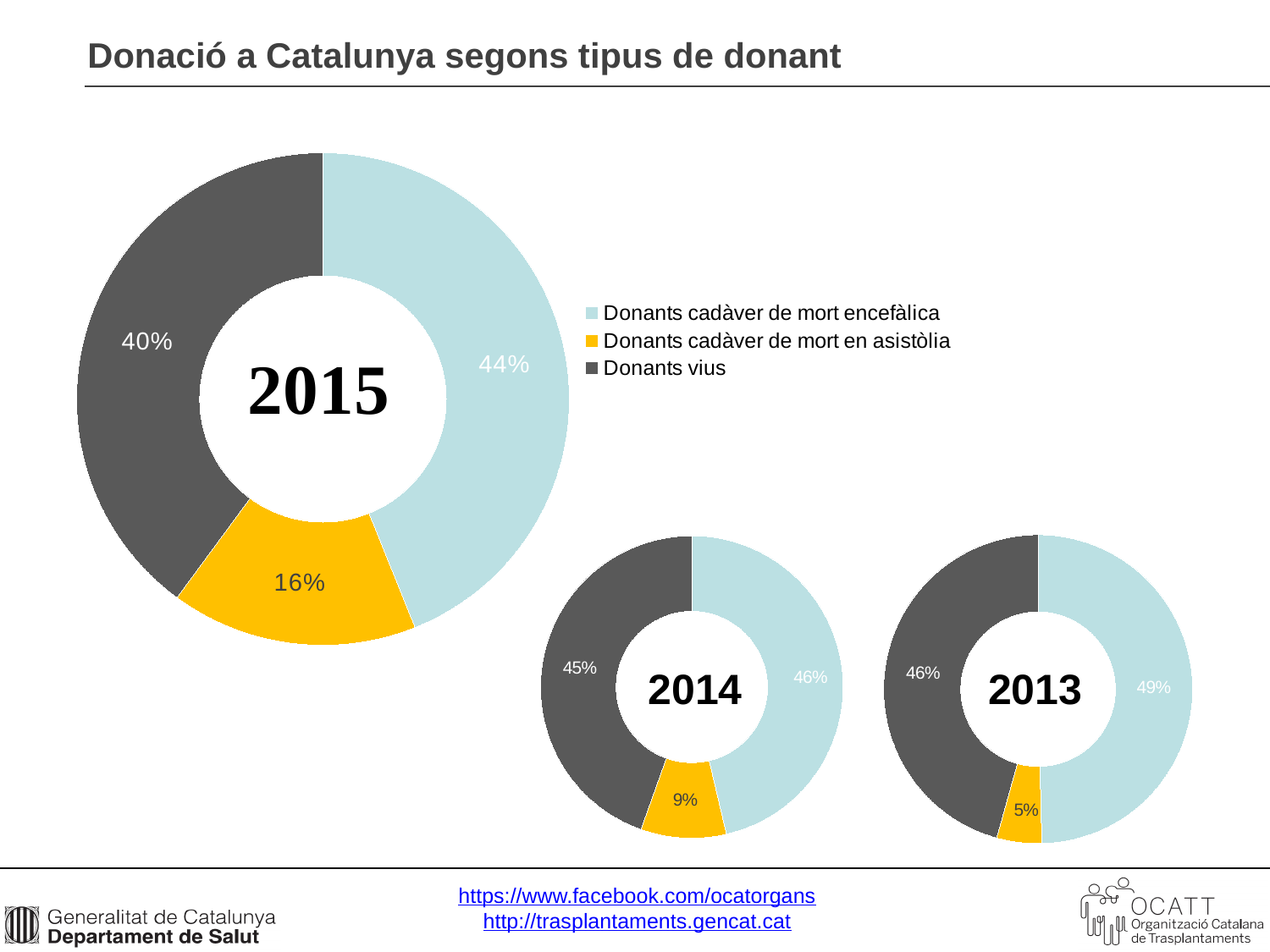
How many series does the legend list? 3 In the 2015 chart, what share is Donants cadàver de mort en asistòlia? 16% How does the Donants cadàver de mort en asistòlia share change from the 2013 chart to the 2015 chart? It rises from 5% to 16% In the 2013 chart, what share is Donants cadàver de mort en asistòlia? 5% In the 2014 chart, what share is Donants vius? 45% In the 2015 chart, what share is Donants cadàver de mort encefàlica? 44% Which is larger in the 2014 chart: Donants cadàver de mort encefàlica or Donants vius? Donants cadàver de mort encefàlica What kind of chart is used for each year on this slide? Donut (pie) chart In the 2015 chart, which donor type has the smallest share? Donants cadàver de mort en asistòlia In the 2013 chart, which donor type has the largest share? Donants cadàver de mort encefàlica In the 2015 chart, what is the difference between the Donants cadàver de mort encefàlica share and the Donants vius share? 4% What colour represents Donants cadàver de mort en asistòlia in the charts? Yellow/orange